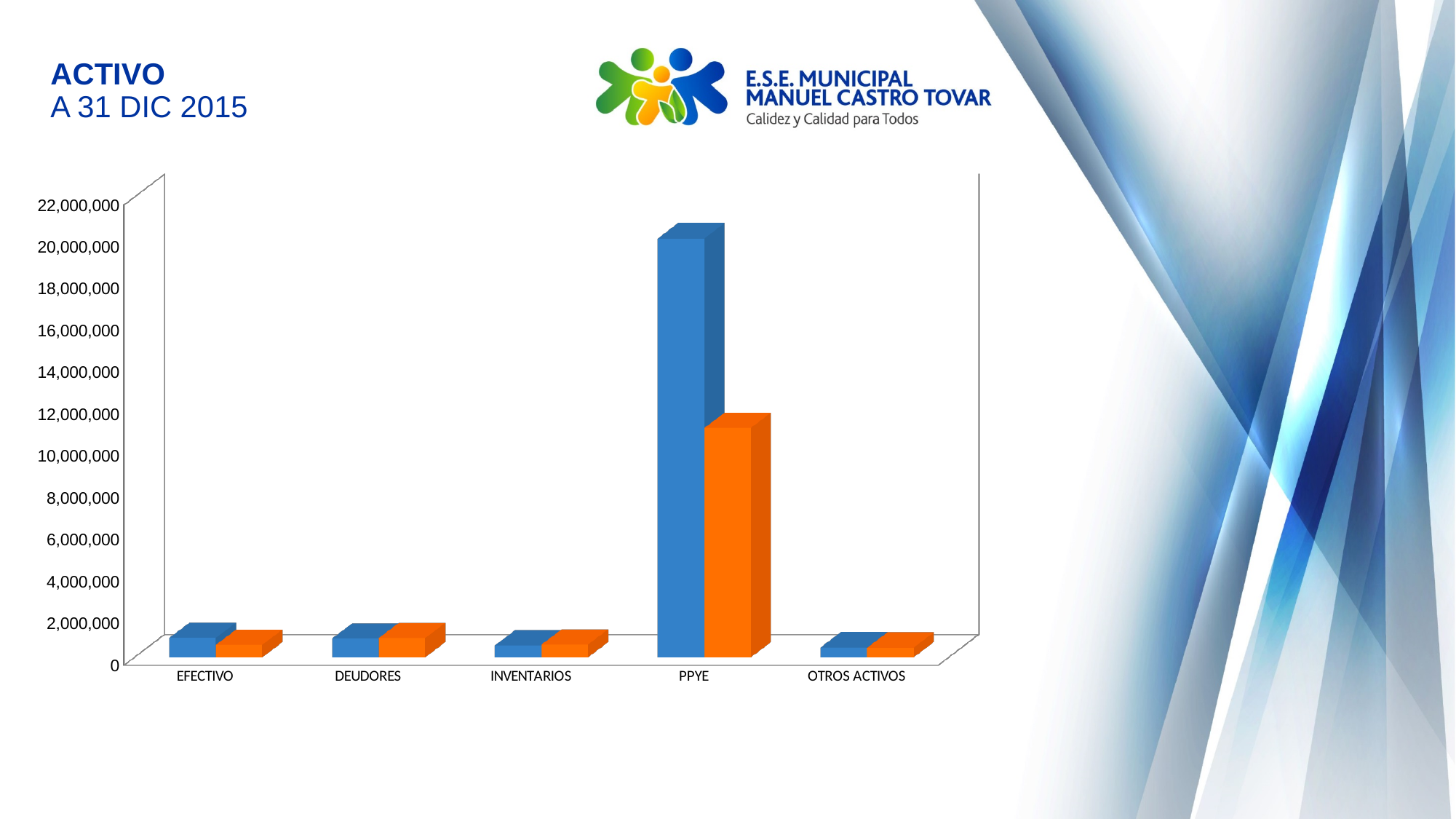
Is the value of the orange bar for PPYE greater or less than 10,000,000? greater Is the value of the blue bar for PPYE greater or less than 18,000,000? greater How many categories are shown on the x axis of the chart? 5 Which category has the tallest bar in the chart? PPYE For PPYE, which bar is larger, the blue one or the orange one? the blue one What is the title shown above the chart on the slide? ACTIVO A 31 DIC 2015 Is the value of the orange bar for PPYE greater or less than 14,000,000? less Which category has the larger blue bar, PPYE or DEUDORES? PPYE What two colours are used for the bars in the chart? blue and orange What kind of chart is shown on the slide? bar chart